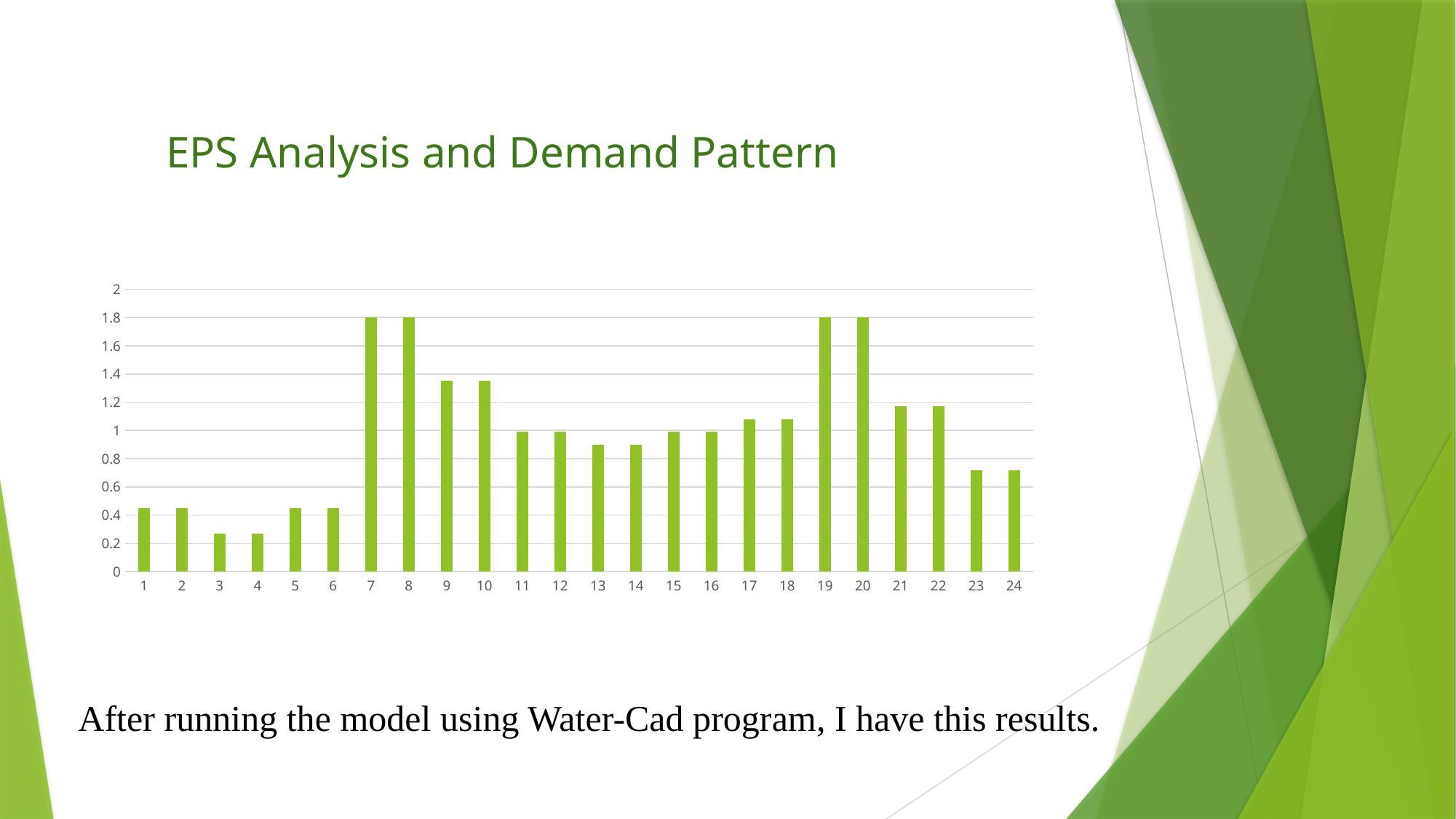
Is the value for category 23 greater or less than 0.8? less What is the value for category 19? 1.8 How many categories are shown on the x axis of the chart? 24 Which is larger, the value for category 4 or the value for category 10? category 10 Is the value for category 1 greater or less than 0.6? less Is the value for category 9 greater or less than 1.2? greater Which is larger, the value for category 8 or the value for category 13? category 8 What kind of chart is shown on the slide? bar chart What is the value for category 7? 1.8 Do the values rise or fall from category 20 to category 24? fall